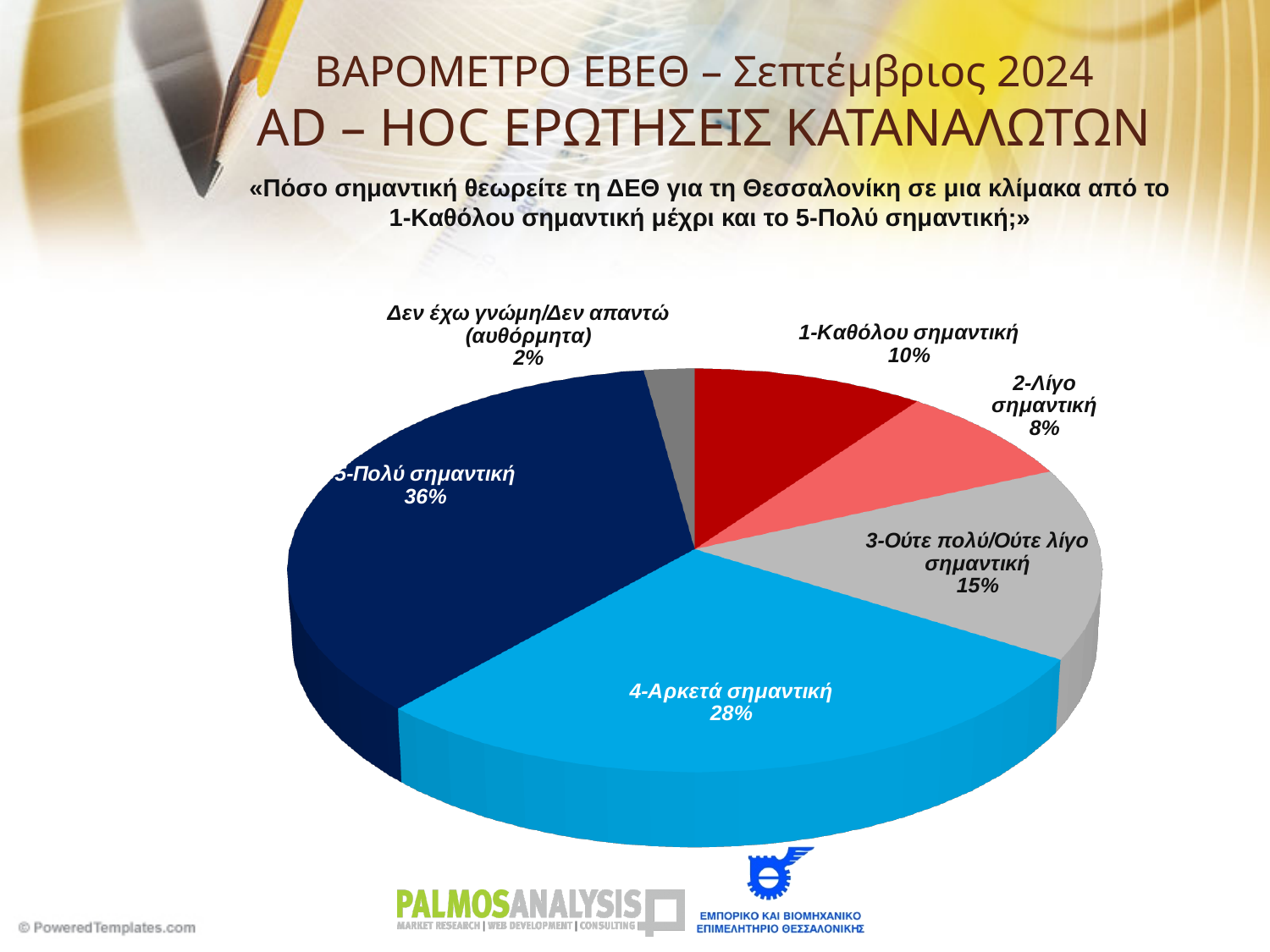
What type of chart is shown on the slide? Pie chart What share of respondents answered "Δεν έχω γνώμη/Δεν απαντώ (αυθόρμητα)"? 2% How many slices does the pie chart have? 6 What share of respondents answered "5-Πολύ σημαντική"? 36% What colour is the slice for "4-Αρκετά σημαντική"? Light blue What is the difference in percentage points between "5-Πολύ σημαντική" and "4-Αρκετά σημαντική"? 8 Which is larger: the share for "1-Καθόλου σημαντική" or the share for "2-Λίγο σημαντική"? 1-Καθόλου σημαντική What share of respondents answered "1-Καθόλου σημαντική"? 10% What share of respondents answered "4-Αρκετά σημαντική"? 28% Which response category has the largest share of the pie? 5-Πολύ σημαντική Which response category has the smallest share of the pie? Δεν έχω γνώμη/Δεν απαντώ (αυθόρμητα) What share of respondents answered "3-Ούτε πολύ/Ούτε λίγο σημαντική"? 15%